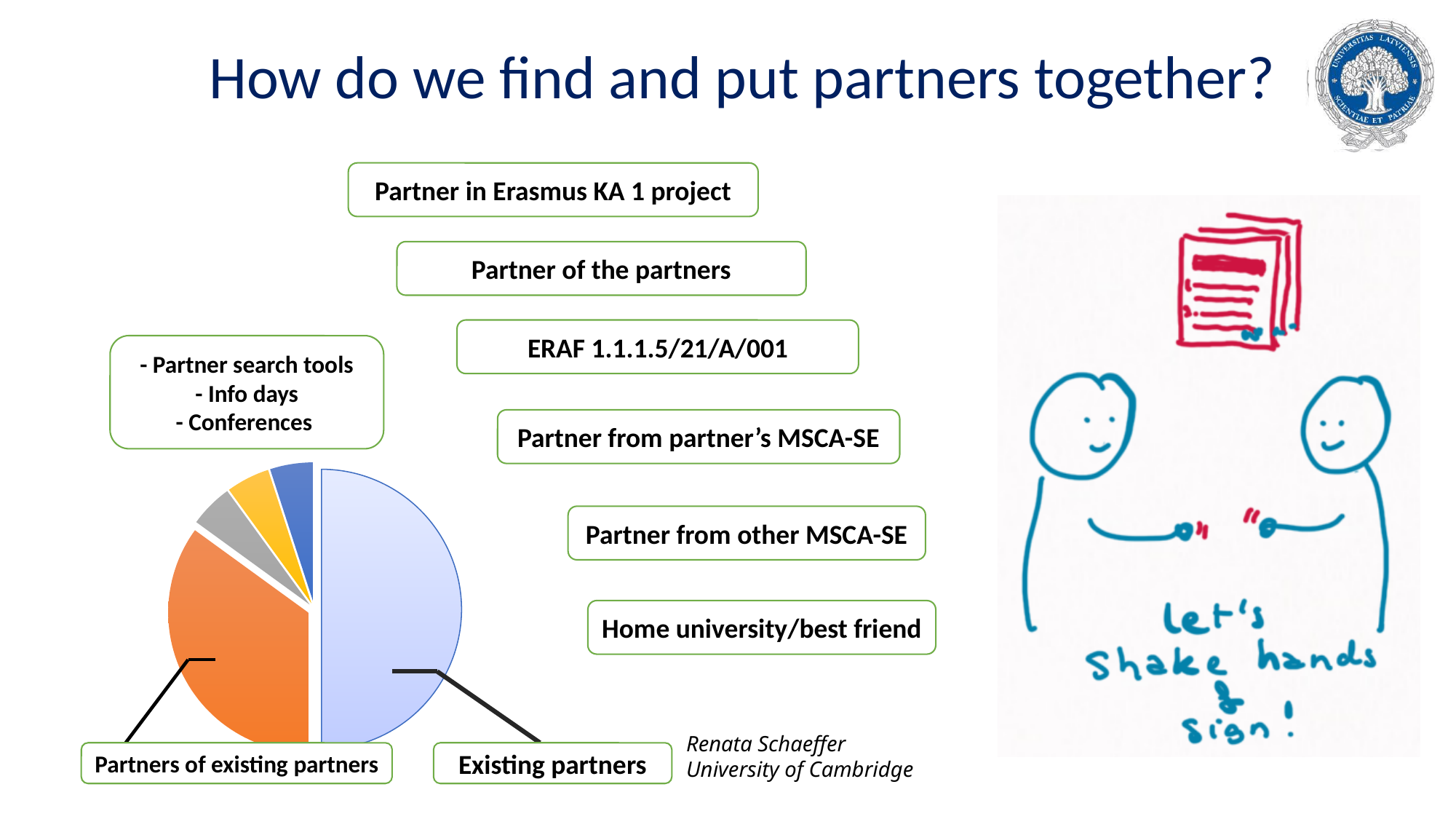
What colour is the Existing partners slice of the pie chart? light blue Which labelled slice of the pie chart is the largest? Existing partners Which is larger in the pie chart: Existing partners or Partners of existing partners? Existing partners How many slices does the pie chart have? 5 What kind of chart is shown on the slide? pie chart Which label is attached to the orange slice of the pie chart? Partners of existing partners